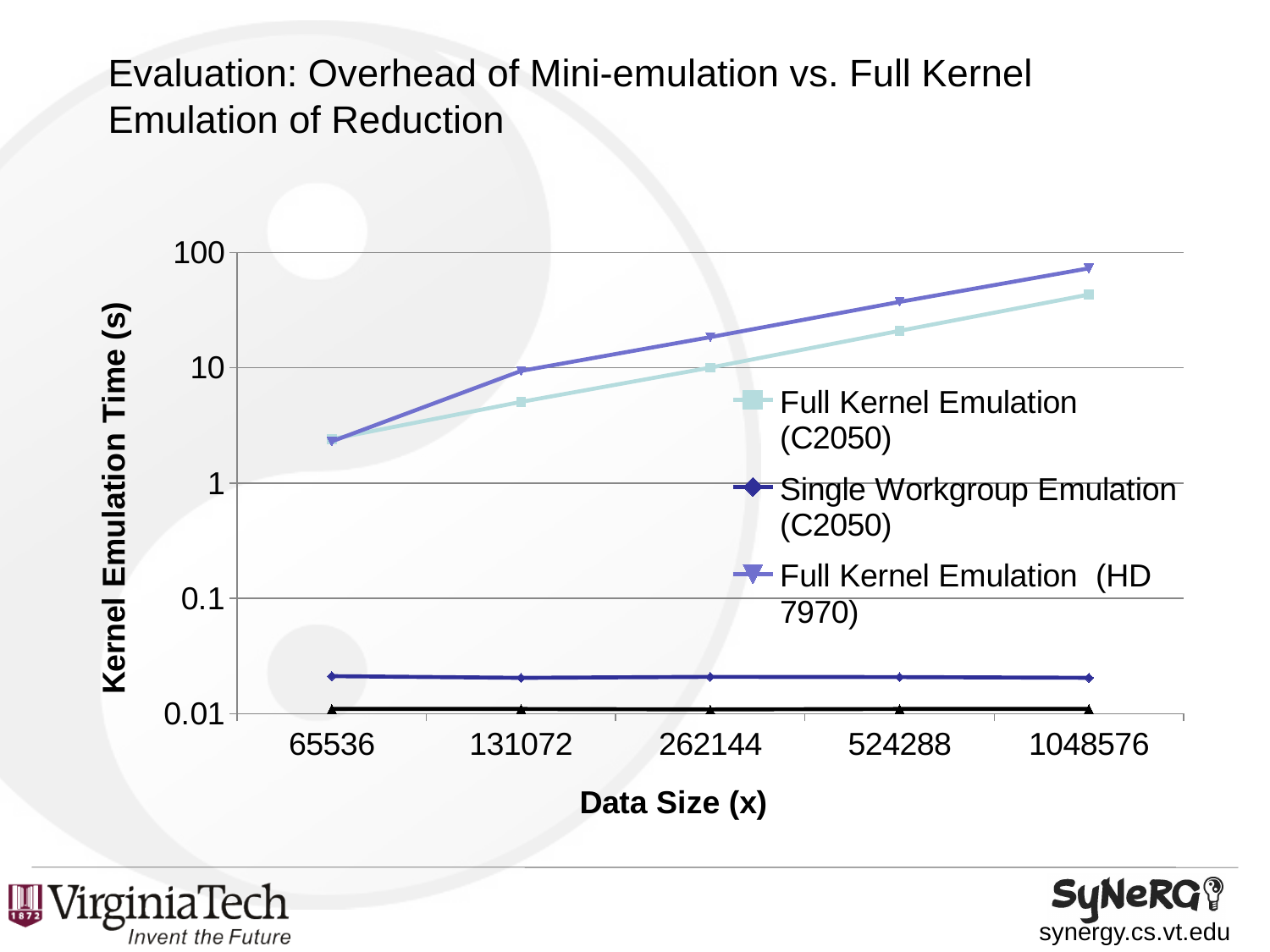
At data size 1048576, which is larger: Full Kernel Emulation (HD 7970) or Full Kernel Emulation (C2050)? Full Kernel Emulation (HD 7970) Is the value for Full Kernel Emulation (HD 7970) at data size 1048576 greater or less than 10? greater What kind of chart is shown on the slide? line chart Does the Full Kernel Emulation (HD 7970) series rise or fall as data size increases? rise Is the value for Full Kernel Emulation (C2050) at data size 65536 greater or less than 1? greater Does the Full Kernel Emulation (C2050) series rise or fall as data size increases? rise How many series does the legend list? 3 What is the title of the y axis? Kernel Emulation Time (s) Which legend series has the highest value at data size 524288? Full Kernel Emulation (HD 7970) Is the value for Single Workgroup Emulation (C2050) at data size 262144 greater or less than 0.1? less How many data size values are plotted along the x axis? 5